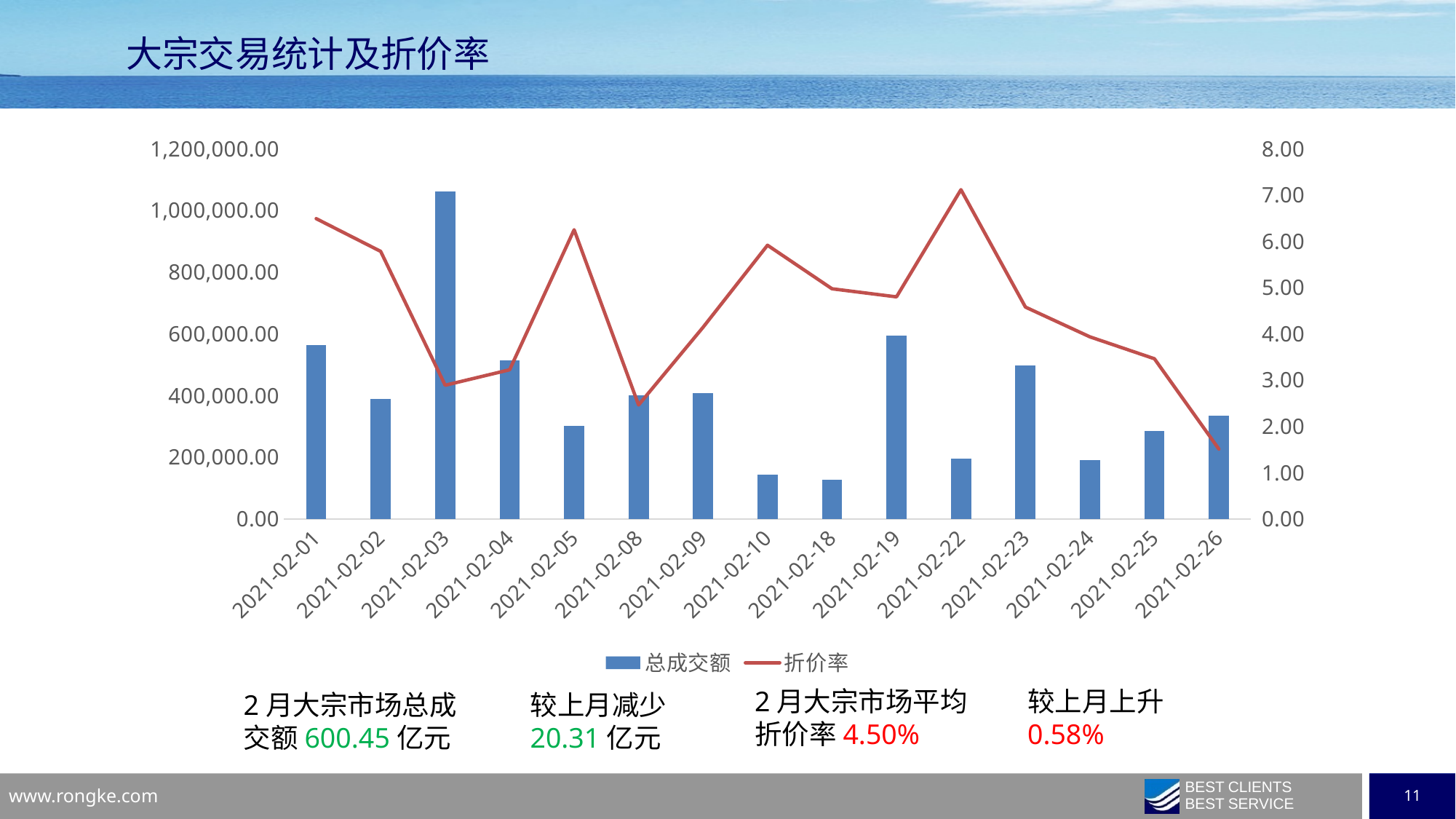
Which date has the larger 总成交额 bar, 2021-02-01 or 2021-02-02? 2021-02-01 Is the 折价率 value for 2021-02-26 greater or less than 2.00? less Is the 总成交额 value for 2021-02-03 greater or less than 1,000,000.00? greater Is the 折价率 value for 2021-02-22 greater or less than 6.00? greater Does the 折价率 line rise or fall from 2021-02-22 to 2021-02-26? It falls On which date is the 总成交额 bar the highest? 2021-02-03 What kind of chart is shown on the slide? A combined bar and line chart How many series does the legend list? 2 On which date does the 折价率 line reach its lowest point? 2021-02-26 How many dates are shown on the x axis? 15 What is the title of the chart on the slide? 大宗交易统计及折价率 On which date does the 折价率 line reach its highest point? 2021-02-22